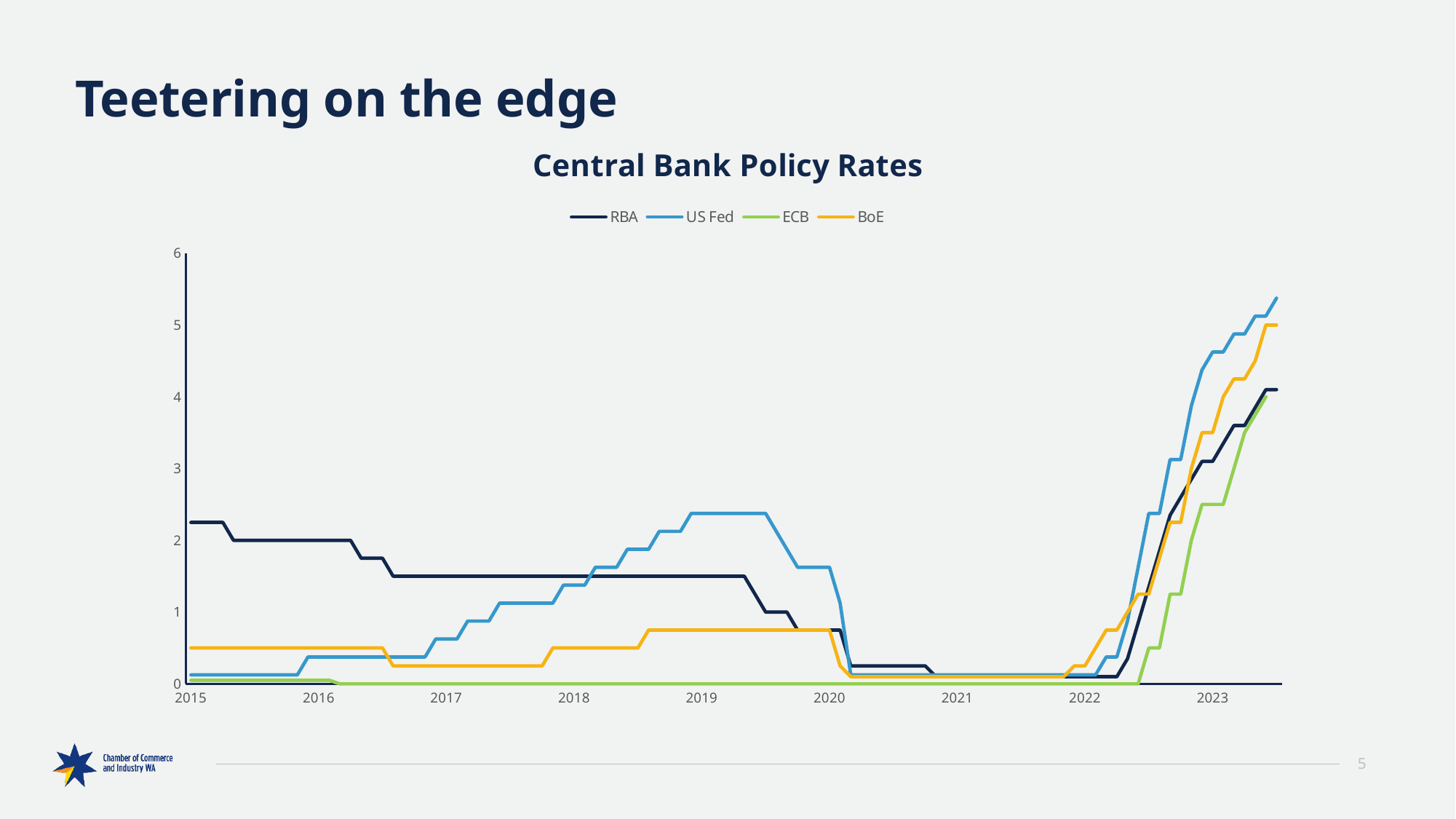
What kind of chart is shown on the slide? line chart Do the policy rates rise or fall between 2022 and 2023? rise Which series has the lowest value during 2021? ECB At the start of 2015, which is larger, the RBA rate or the ECB rate? RBA Is the US Fed value at the end of 2023 greater or less than 5? greater How many series does the legend of the Central Bank Policy Rates chart list? 4 Which series is drawn in green in the Central Bank Policy Rates chart? ECB Is the RBA value at the start of 2015 greater or less than 2? greater What is the title of the chart? Central Bank Policy Rates Is the BoE value during 2019 greater or less than 1? less Which series has the highest value at the end of 2023? US Fed